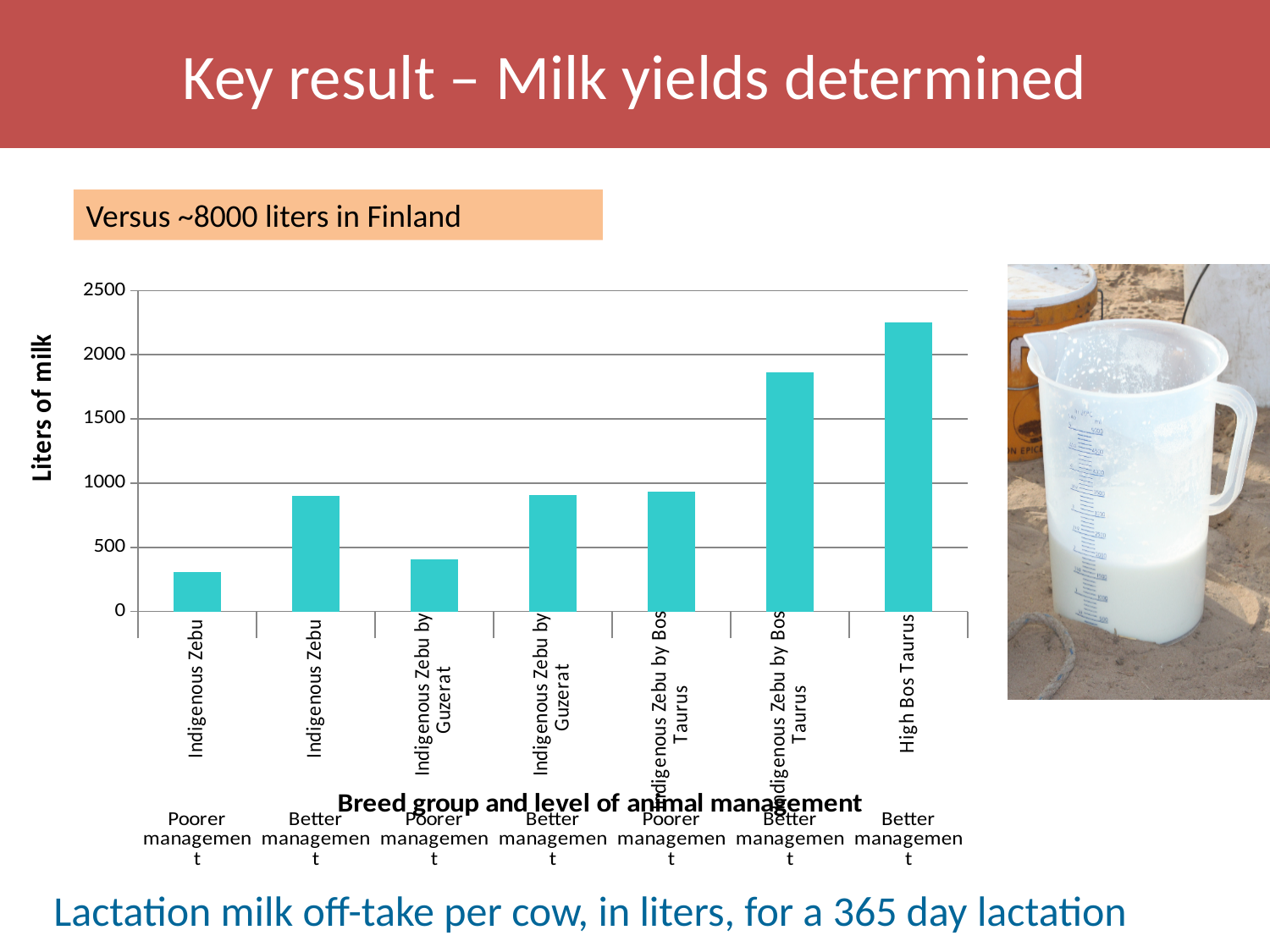
Is the value for Indigenous Zebu by Bos Taurus under better management greater or less than 1500? greater Is the value for Indigenous Zebu under poorer management greater or less than 500? less What kind of chart is shown on the slide? bar chart Is the value for Indigenous Zebu under better management greater or less than 1000? less What is the title of the vertical axis? Liters of milk Which breed group and management level has the lowest milk yield? Indigenous Zebu, poorer management What is the title of the horizontal axis? Breed group and level of animal management Which is larger: the value for Indigenous Zebu by Bos Taurus under better management or the value for Indigenous Zebu by Bos Taurus under poorer management? Indigenous Zebu by Bos Taurus under better management How many bars are plotted in the chart? 7 Which breed group and management level has the highest milk yield? High Bos Taurus, better management